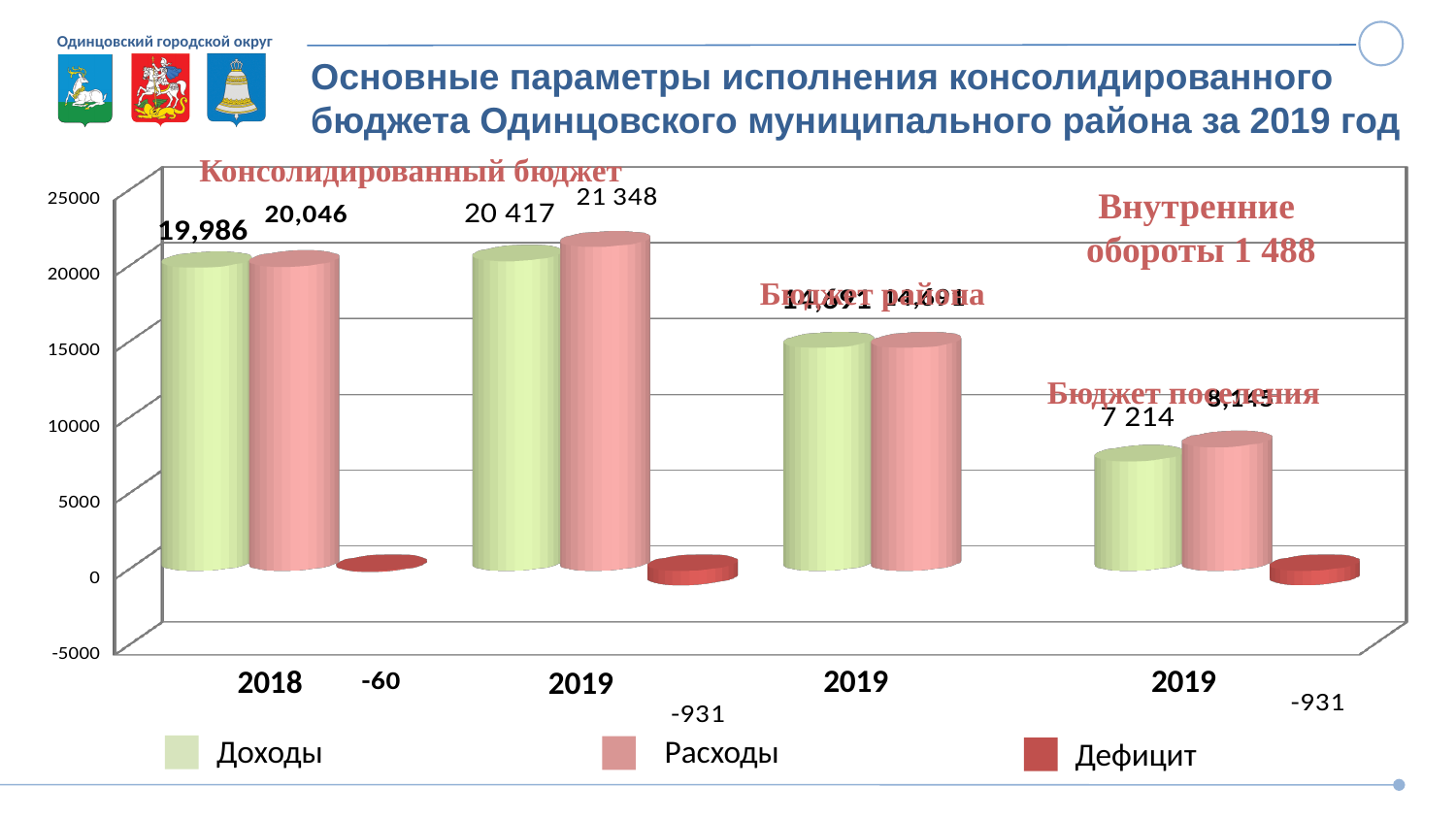
What is the value of Расходы for 2019 in the Консолидированный бюджет group? 21 348 Is the value of Доходы for 2019 in the Бюджет района group greater or less than 10000? greater What is the value of Доходы for 2019 in the Консолидированный бюджет group? 20 417 What kind of chart is shown on the slide? bar chart What is the value of Доходы for 2019 in the Бюджет поселения group? 7 214 Is the value of Расходы for 2019 in the Бюджет поселения group greater or less than 10000? less What is the value of Дефицит for 2018? -60 What colour represents the Дефицит series in the legend? red Which is larger for 2018: Доходы or Расходы? Расходы What is the value of Расходы for 2018 (Консолидированный бюджет)? 20,046 How many series does the chart legend list? 3 What is the value of Доходы for 2018 (Консолидированный бюджет)? 19,986